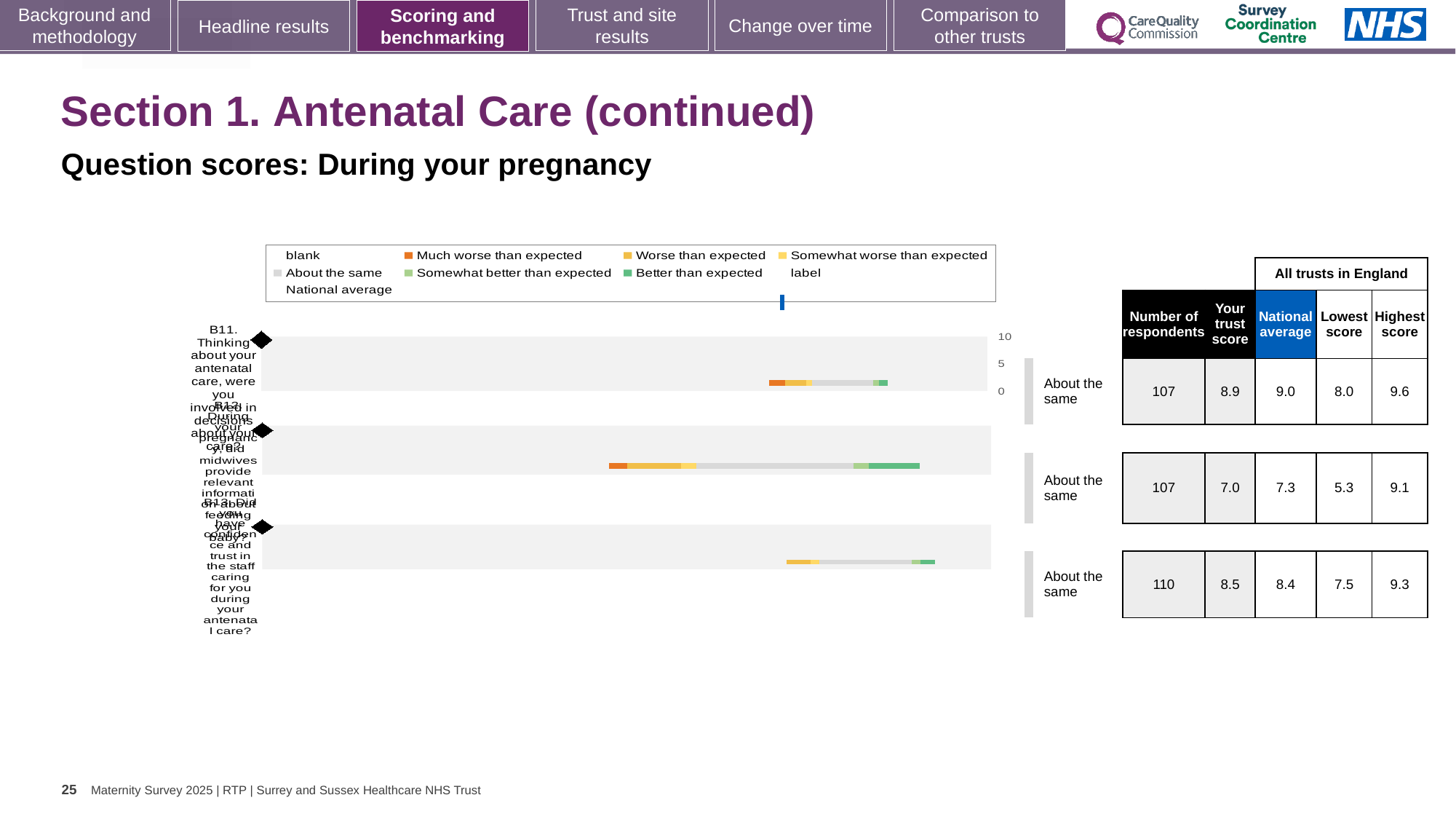
How many entries does the chart legend list? 9 For question B13, is the trust score higher or lower than the national average? higher What kind of chart is used to show the question scores on this slide? bar chart Which question has the highest 'Your trust score'? B11 What benchmark label is shown next to each of the three bars? About the same What is the difference between the highest score and the lowest score for question B12? 3.8 What is the national average for question B12? 7.3 What is the 'Your trust score' for question B11? 8.9 How many respondents are recorded for question B13? 110 Which question has the lowest 'Your trust score'? B12 What is the lowest score across all trusts in England for question B11? 8.0 How many questions (bars) are plotted in the chart? 3